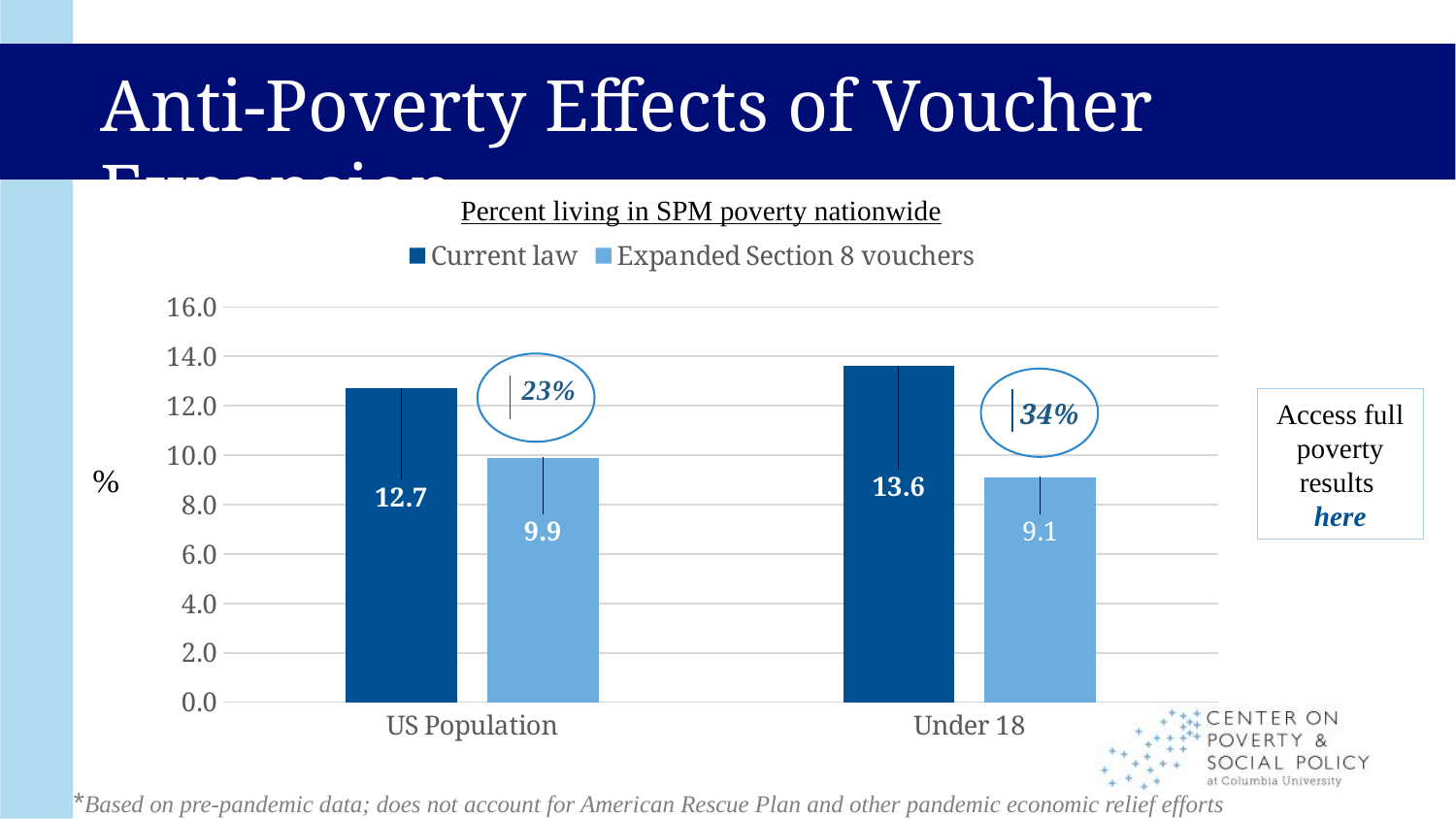
What is the Current law value for Under 18? 13.6 Which category has the highest Current law value? Under 18 Which is larger for US Population: the Current law value or the Expanded Section 8 vouchers value? Current law What is the title of the chart? Percent living in SPM poverty nationwide What kind of chart is shown on the slide? Bar chart How many series does the legend list? 2 Which category has the lowest Expanded Section 8 vouchers value? Under 18 How many categories are shown on the x axis? 2 What is the Expanded Section 8 vouchers value for Under 18? 9.1 What is the difference between the Current law and Expanded Section 8 vouchers values for Under 18? 4.5 What is the Expanded Section 8 vouchers value for US Population? 9.9 What is the Current law value for US Population? 12.7